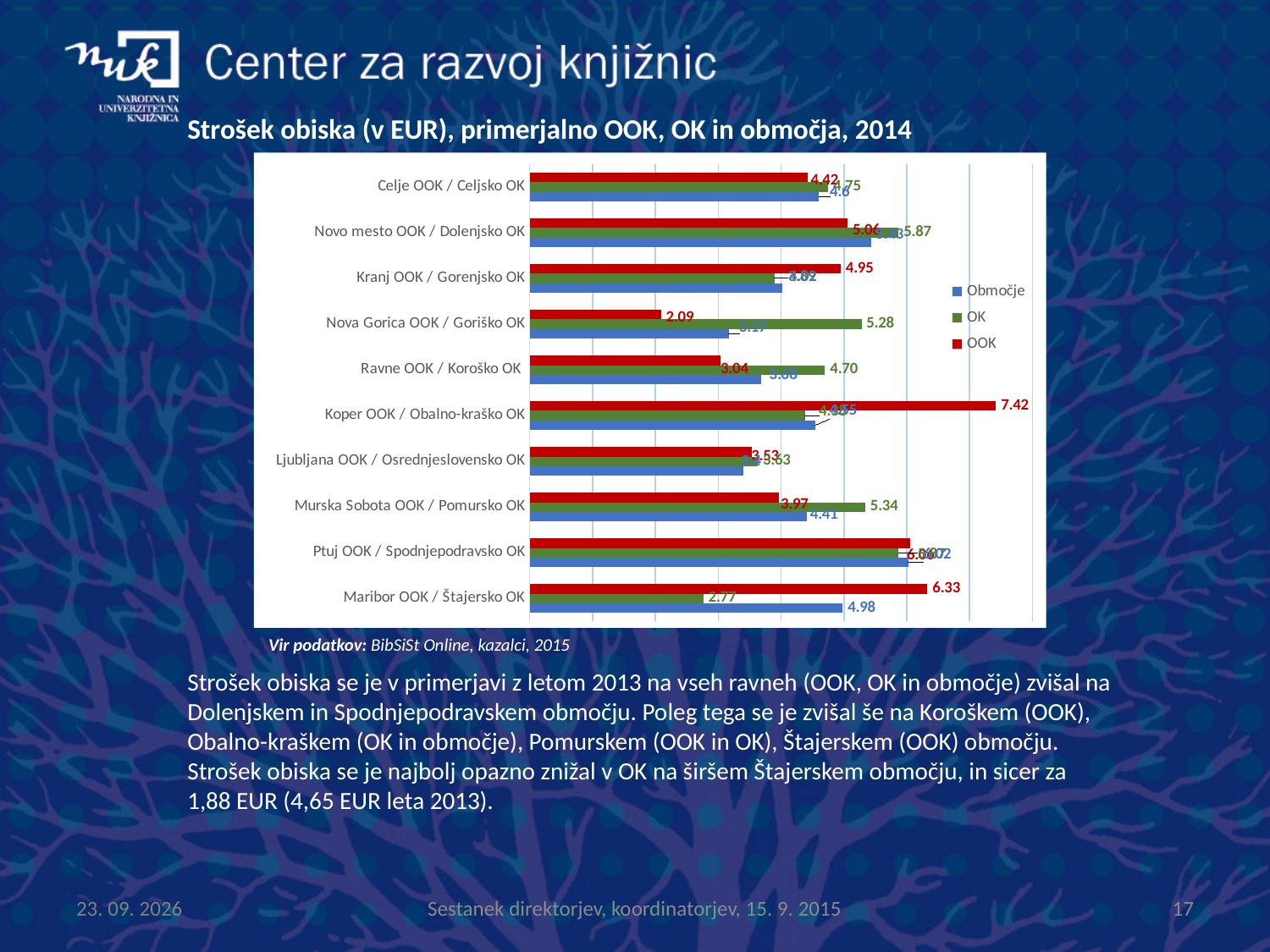
How many series does the legend list? 3 What is the Območje value for Murska Sobota OOK / Pomursko OK? 4.41 What is the OOK value for Nova Gorica OOK / Goriško OK? 2.09 How many categories (regions) are shown on the chart? 10 For Nova Gorica OOK / Goriško OK, which is larger: the OK value or the OOK value? OK What is the OK value for Maribor OOK / Štajersko OK? 2.77 What is the OOK value for Koper OOK / Obalno-kraško OK? 7.42 What is the title of the chart? Strošek obiska (v EUR), primerjalno OOK, OK in območja, 2014 Which category has the lowest OOK value? Nova Gorica OOK / Goriško OK What kind of chart is shown on the slide? Bar chart What is the difference between the OOK and OK values for Maribor OOK / Štajersko OK? 3.56 Which category has the highest OOK value? Koper OOK / Obalno-kraško OK